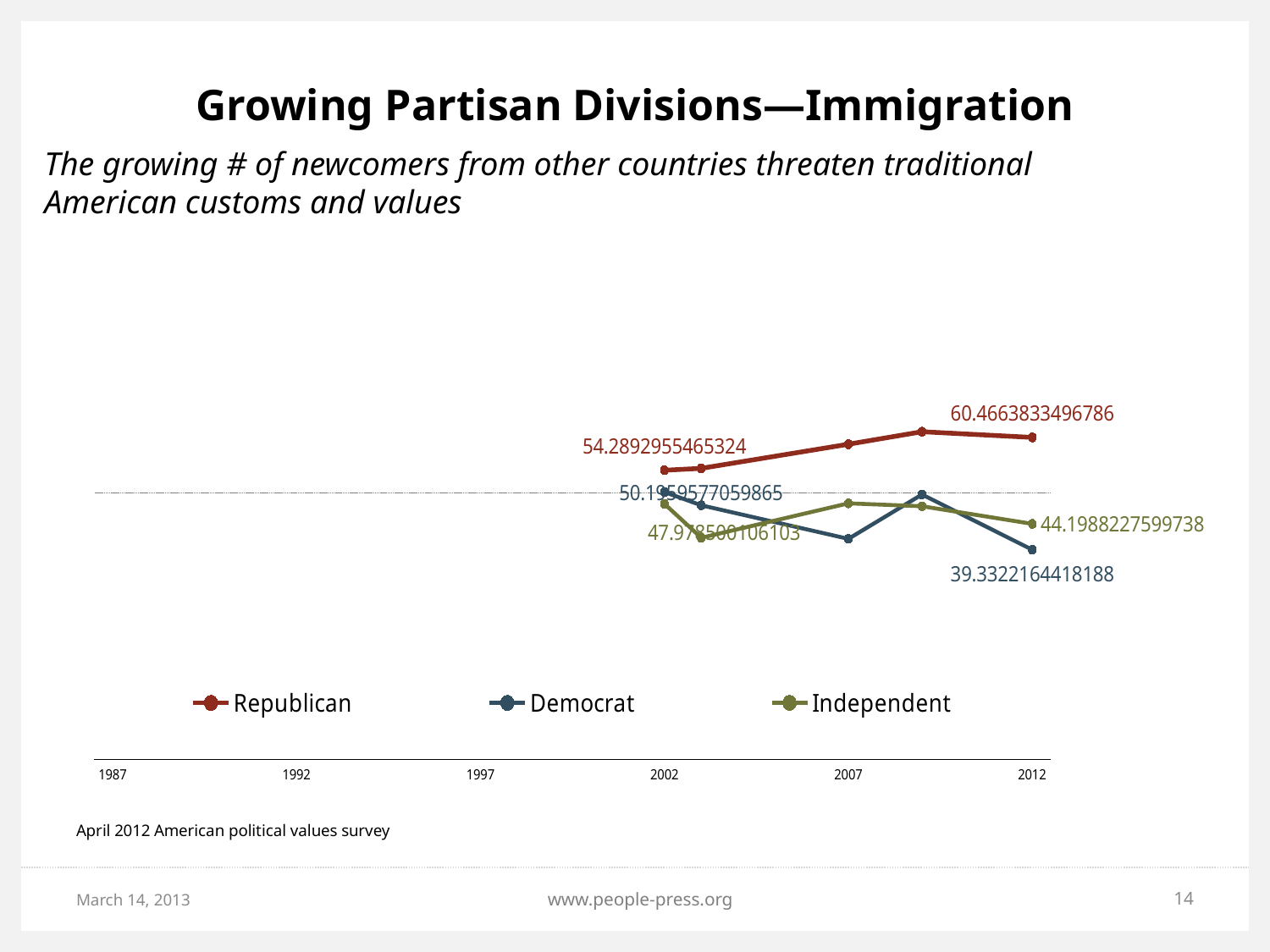
What is the value for Independent in 2012? 44.1988227599738 What are the three entries in the chart legend? Republican, Democrat, Independent Which series has the lowest value in 2012? Democrat Which series has the highest value in 2012? Republican What kind of chart is shown on the slide? line chart What is the value for Republican in 2002? 54.2892955465324 How many series does the legend list? 3 In 2012, which is larger: the Republican value or the Independent value? Republican What is the value for Republican in 2012? 60.4663833496786 What is the difference between the Republican value in 2012 and the Republican value in 2002? 6.1770878031462 Does the Republican line rise or fall from 2002 to 2012? rises What is the value for Democrat in 2012? 39.3322164418188